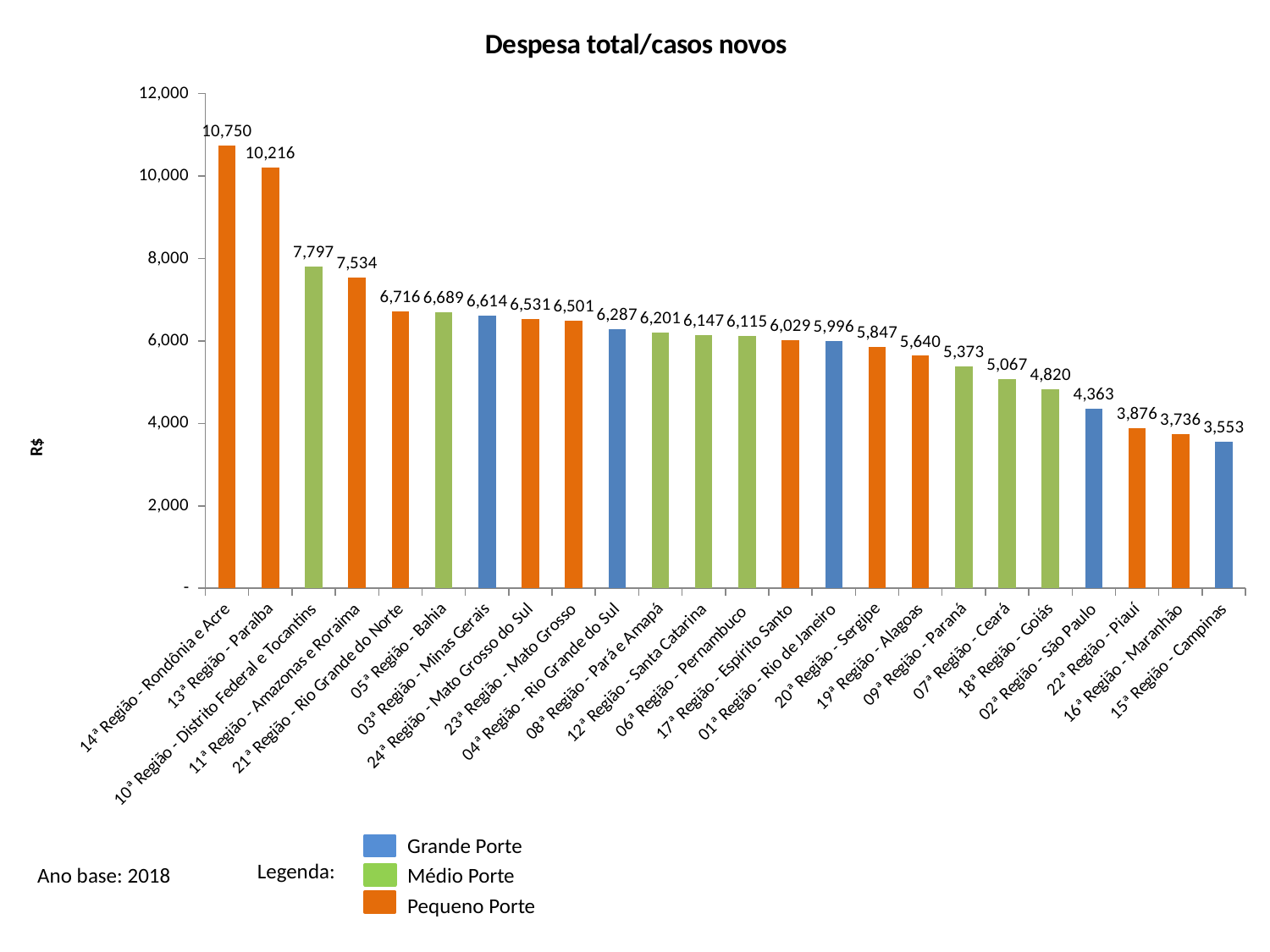
Is the value for 22ª Região - Piauí greater or less than 4,000? less What is the difference between the values for 14ª Região - Rondônia e Acre and 13ª Região - Paraíba? 534 Which is larger, the value for 10ª Região - Distrito Federal e Tocantins or 11ª Região - Amazonas e Roraima? 10ª Região - Distrito Federal e Tocantins How many categories does the legend list? 3 Which region has the highest value? 14ª Região - Rondônia e Acre What is the value for 03ª Região - Minas Gerais? 6,614 Which region has the lowest value? 15ª Região - Campinas What kind of chart is shown? bar chart What is the value for 02ª Região - São Paulo? 4,363 What is the value for 14ª Região - Rondônia e Acre? 10,750 How many regions are shown on the chart? 24 What is the title of the chart? Despesa total/casos novos